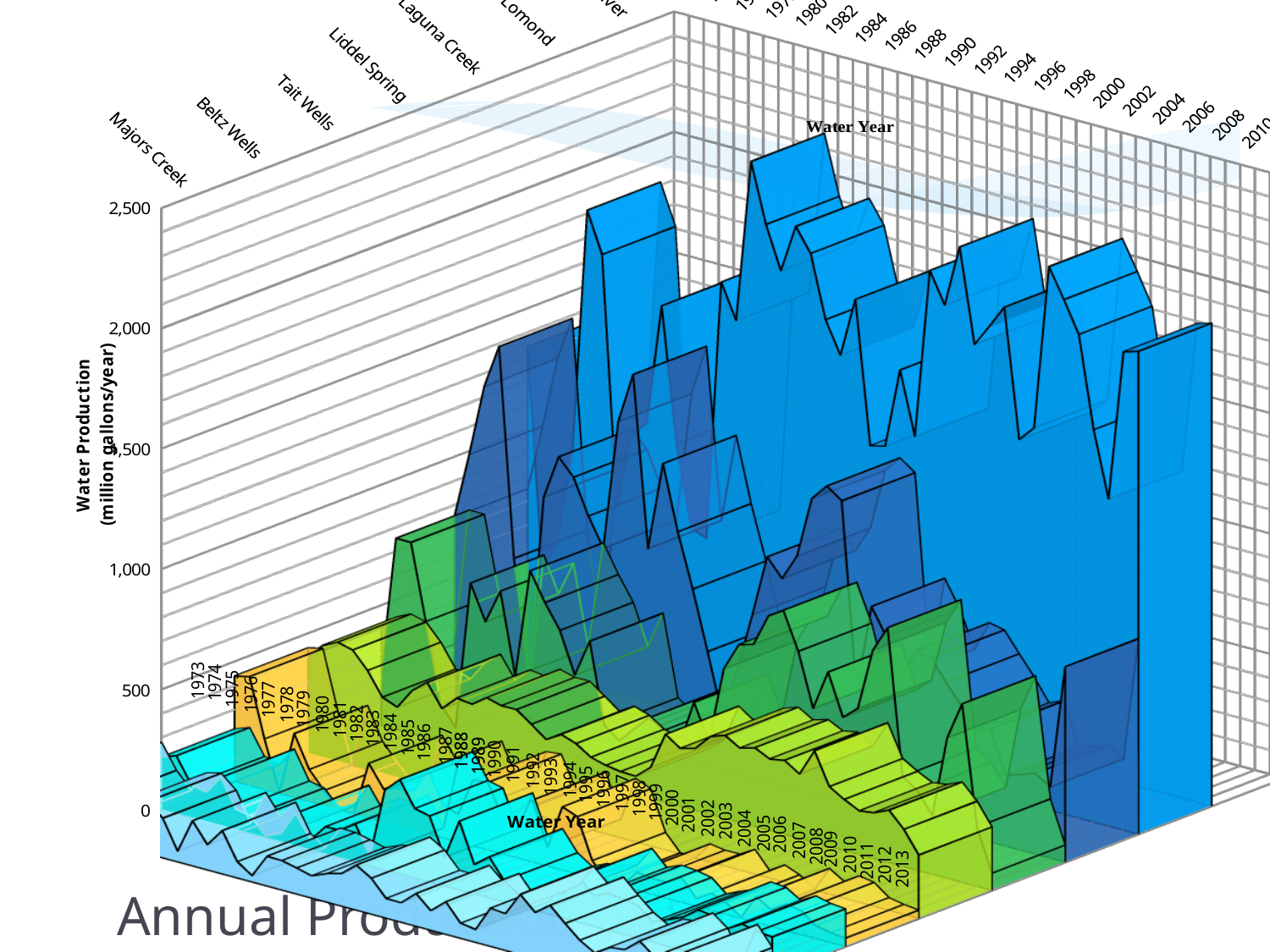
What is the highest tick value shown on the vertical axis of the chart? 2,500 What is the latest water year shown on the chart's year axis? 2013 Which source is listed between Tait Wells and Laguna Creek on the chart's depth axis? Liddel Spring What is the label of the axis that runs along the years in the chart? Water Year What is the title of the vertical axis of the chart? Water Production (million gallons/year) Which source is listed first (nearest the front) on the chart's depth axis? Majors Creek What is the lowest tick value shown on the vertical axis of the chart? 0 What kind of chart is shown on the slide? 3D area chart Which source is listed immediately after Beltz Wells on the chart's depth axis? Tait Wells